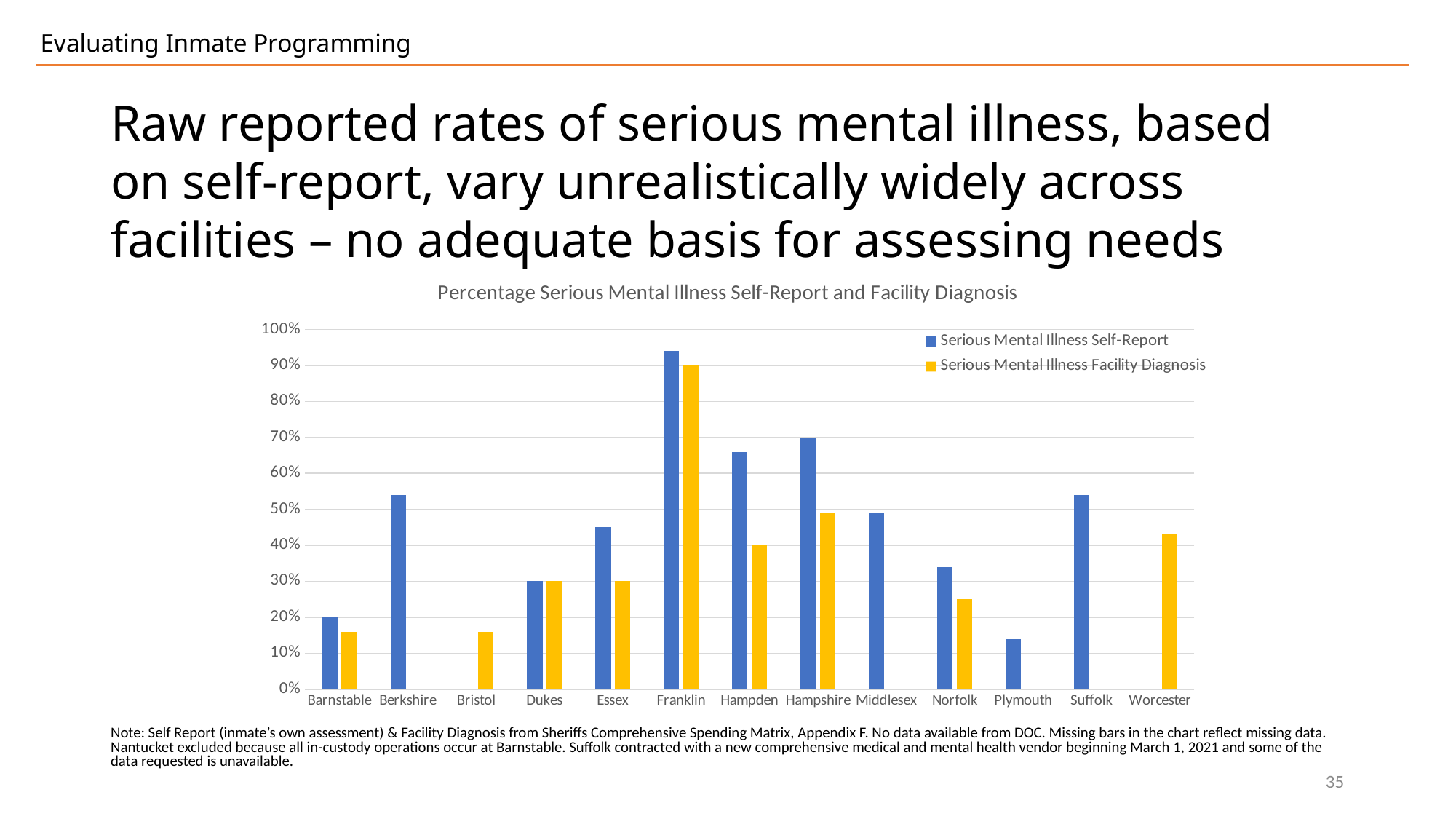
Among facilities with a Self-Report bar, which has the lowest Serious Mental Illness Self-Report value? Plymouth Is the Serious Mental Illness Self-Report value for Hampshire greater or less than 60%? greater Which facility has the highest Serious Mental Illness Facility Diagnosis value? Franklin Is the Serious Mental Illness Self-Report value for Franklin greater or less than 80%? greater Which facility has the highest Serious Mental Illness Self-Report value? Franklin What is the title of the chart? Percentage Serious Mental Illness Self-Report and Facility Diagnosis Is the Serious Mental Illness Facility Diagnosis value for Norfolk greater or less than 30%? less How many series does the legend list? 2 What kind of chart is shown on the slide? Bar chart For Essex, which is larger: the Self-Report value or the Facility Diagnosis value? Self-Report How many facilities are shown on the x axis? 13